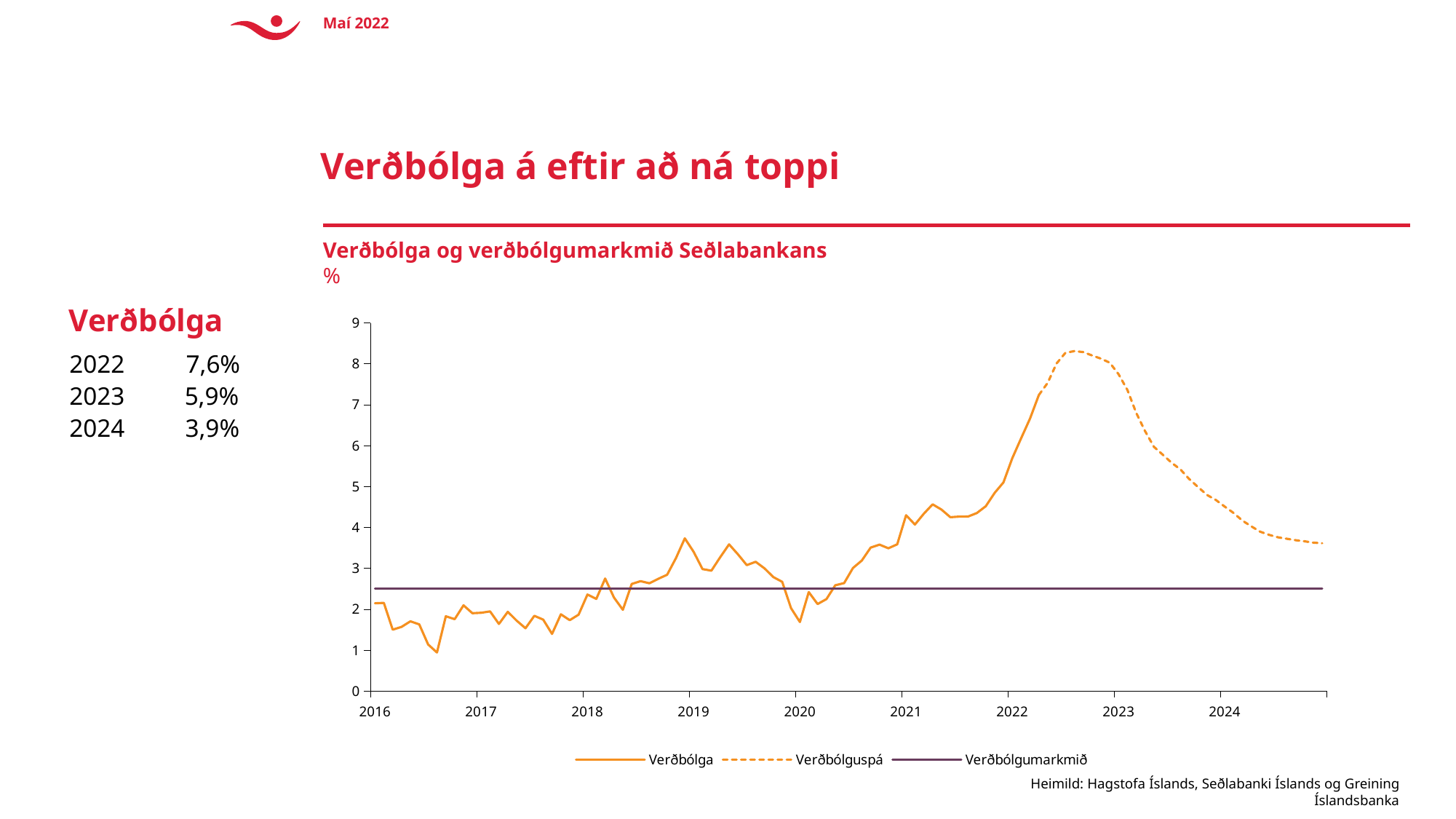
Which legend entry is drawn as a dashed line? Verðbólguspá Is the Verðbólga value at the start of 2016 greater or less than 3? less How many series does the chart legend list? 3 Is the peak value of the Verðbólguspá line greater or less than 8? greater How many year labels are shown on the x axis? 9 Is the Verðbólgumarkmið line greater or less than 3? less Does the Verðbólga line rise or fall between 2020 and 2022? rise Does the Verðbólguspá line rise or fall between 2023 and 2024? fall What kind of chart is shown on the slide? line chart What is the title of the chart? Verðbólga og verðbólgumarkmið Seðlabankans At the start of 2022, which is larger: Verðbólga or Verðbólgumarkmið? Verðbólga